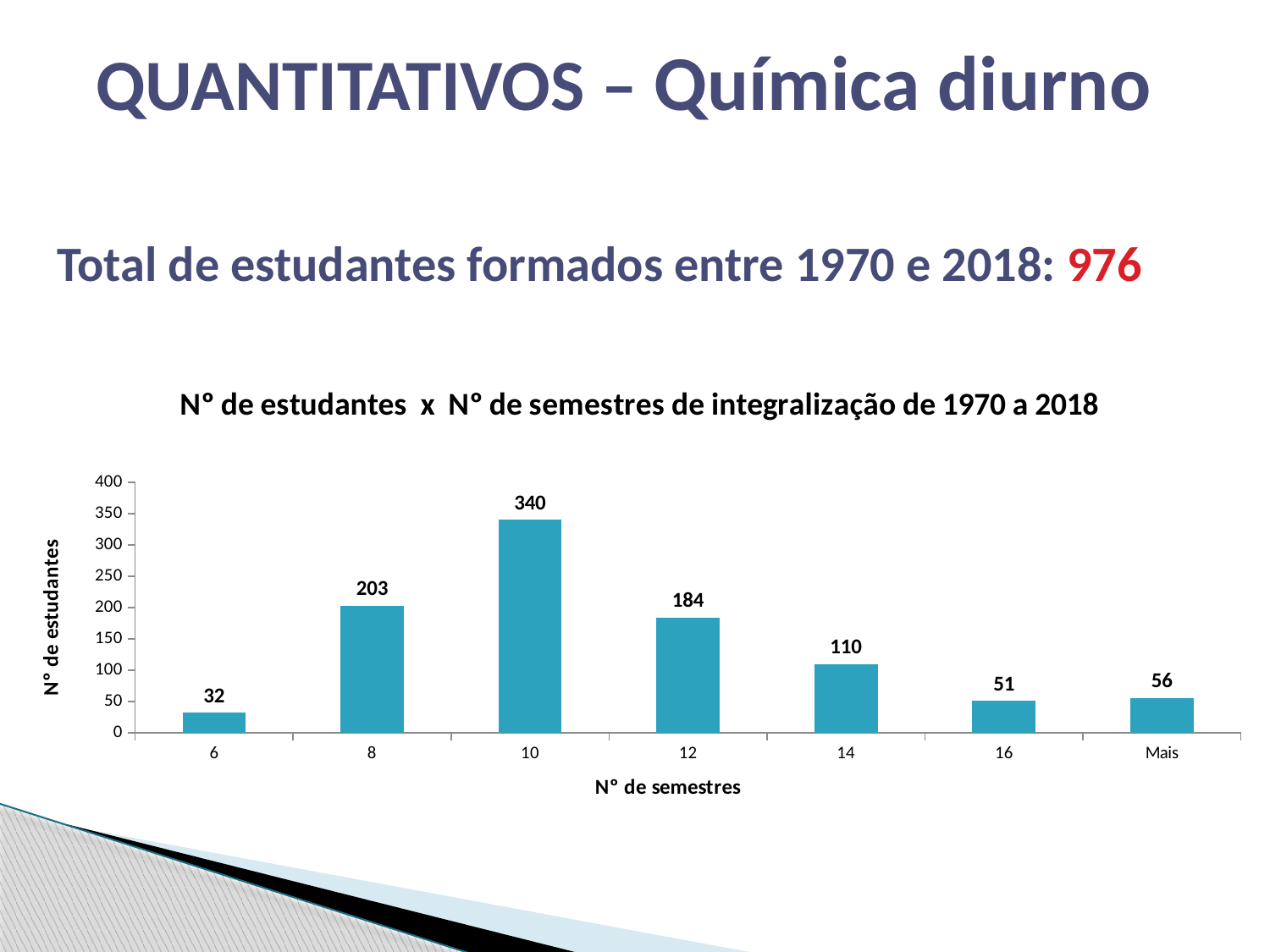
Which has more students: 14 semesters or 16 semesters? 14 semesters Which number of semesters has the lowest number of students? 6 What is the number of students for 6 semesters? 32 What is the number of students for the 'Mais' category? 56 What is the difference between the number of students for 8 semesters and for 12 semesters? 19 What is the number of students for 10 semesters? 340 What is the label of the y axis? N° de estudantes Is the value for 12 semesters greater or less than 150? greater What kind of chart is shown on the slide? Bar chart How many categories are shown on the x axis? 7 What is the title of the chart? N° de estudantes x N° de semestres de integralização de 1970 a 2018 Which number of semesters has the highest number of students? 10